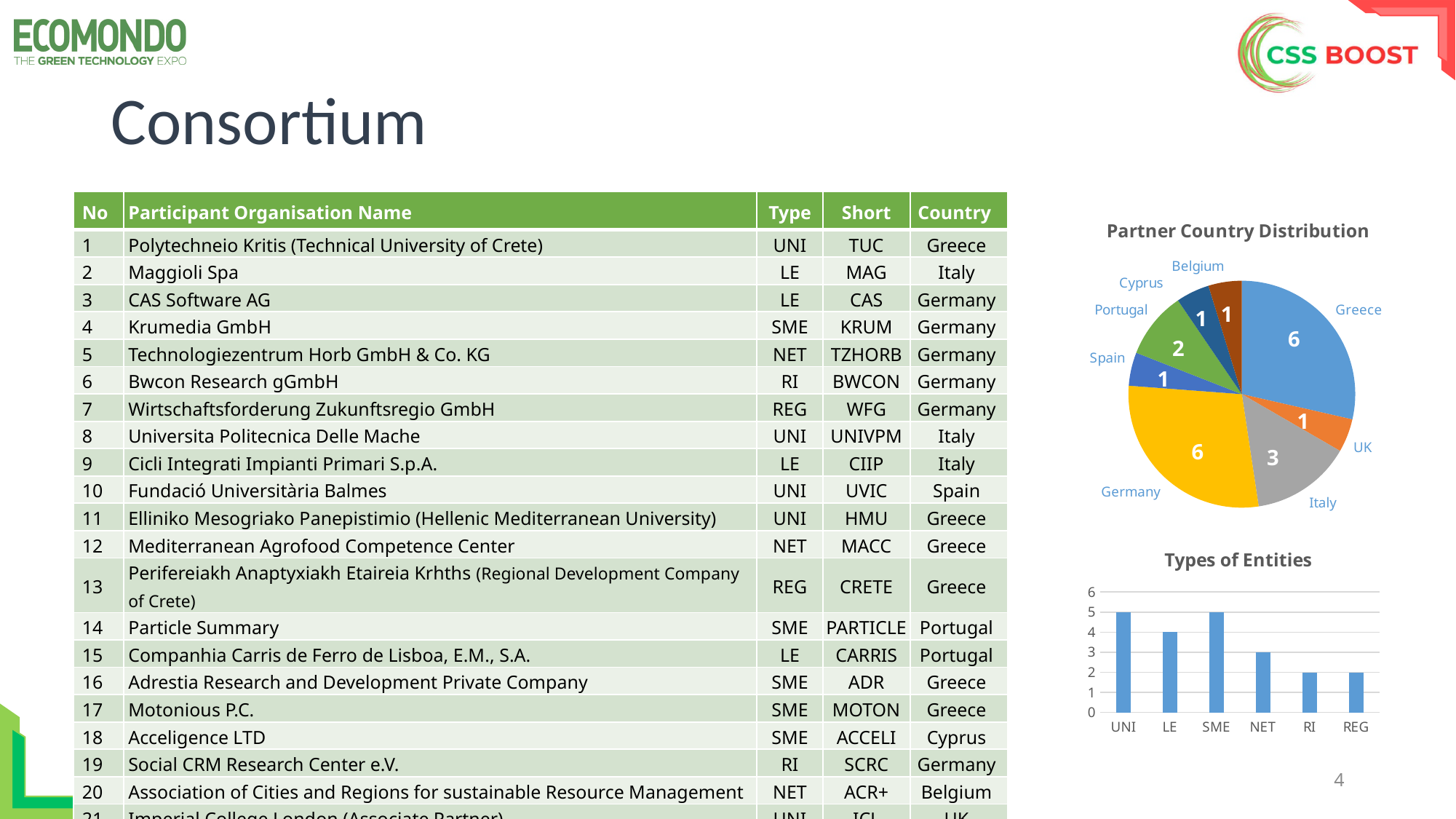
In the Types of Entities bar chart, how many entity types are shown on the x axis? 6 In the Partner Country Distribution pie chart, what is the difference between the number of partners from Germany and from Italy? 3 In the Partner Country Distribution pie chart, how many partners are from Portugal? 2 In the Types of Entities bar chart, which has the larger value, LE or RI? LE In the Types of Entities bar chart, what is the value for LE? 4 In the Partner Country Distribution pie chart, what is the total number of partners across all countries? 21 In the Partner Country Distribution pie chart, how many partners are from Italy? 3 In the Partner Country Distribution pie chart, which country has the smallest number of partners among Italy, Portugal and Spain? Spain In the Partner Country Distribution pie chart, how many partners are from Greece? 6 In the Partner Country Distribution pie chart, how many countries are shown? 8 In the Types of Entities bar chart, what is the value for NET? 3 What kind of chart is the Types of Entities chart? bar chart